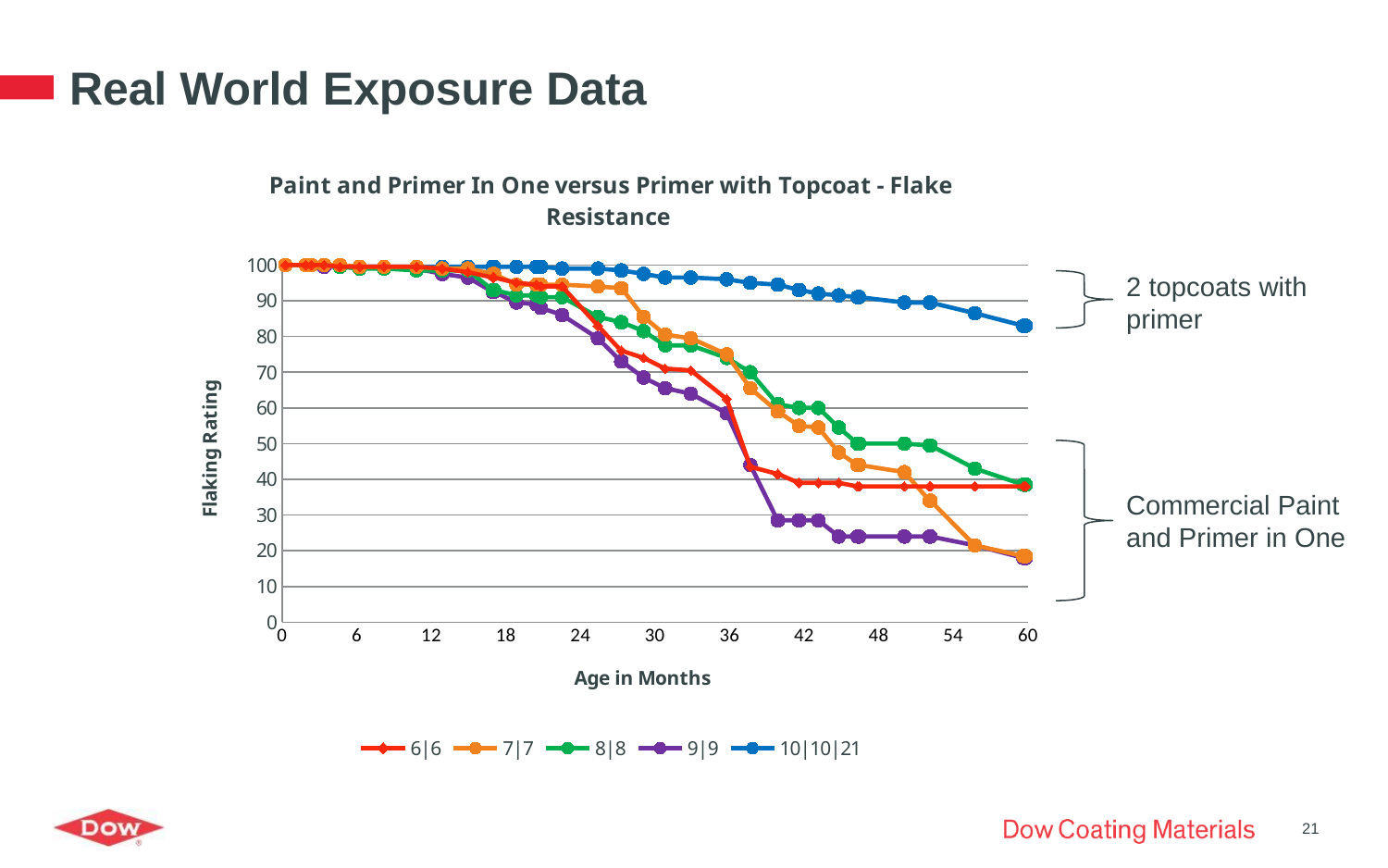
Is the value for 10|10|21 at 60 months greater or less than 70? greater How many series does the legend list? 5 What is the label of the y axis? Flaking Rating What kind of chart is shown on the slide? line chart At 42 months, which series has the larger value, 8|8 or 9|9? 8|8 What is the title of the chart? Paint and Primer In One versus Primer with Topcoat - Flake Resistance Do the flaking rating values rise or fall as age in months increases? fall Is the value for 9|9 at 48 months greater or less than 30? less At 48 months, which series has the larger value, 10|10|21 or 6|6? 10|10|21 Which series has the highest flaking rating at 60 months? 10|10|21 Is the value for 8|8 at 30 months greater or less than 70? greater